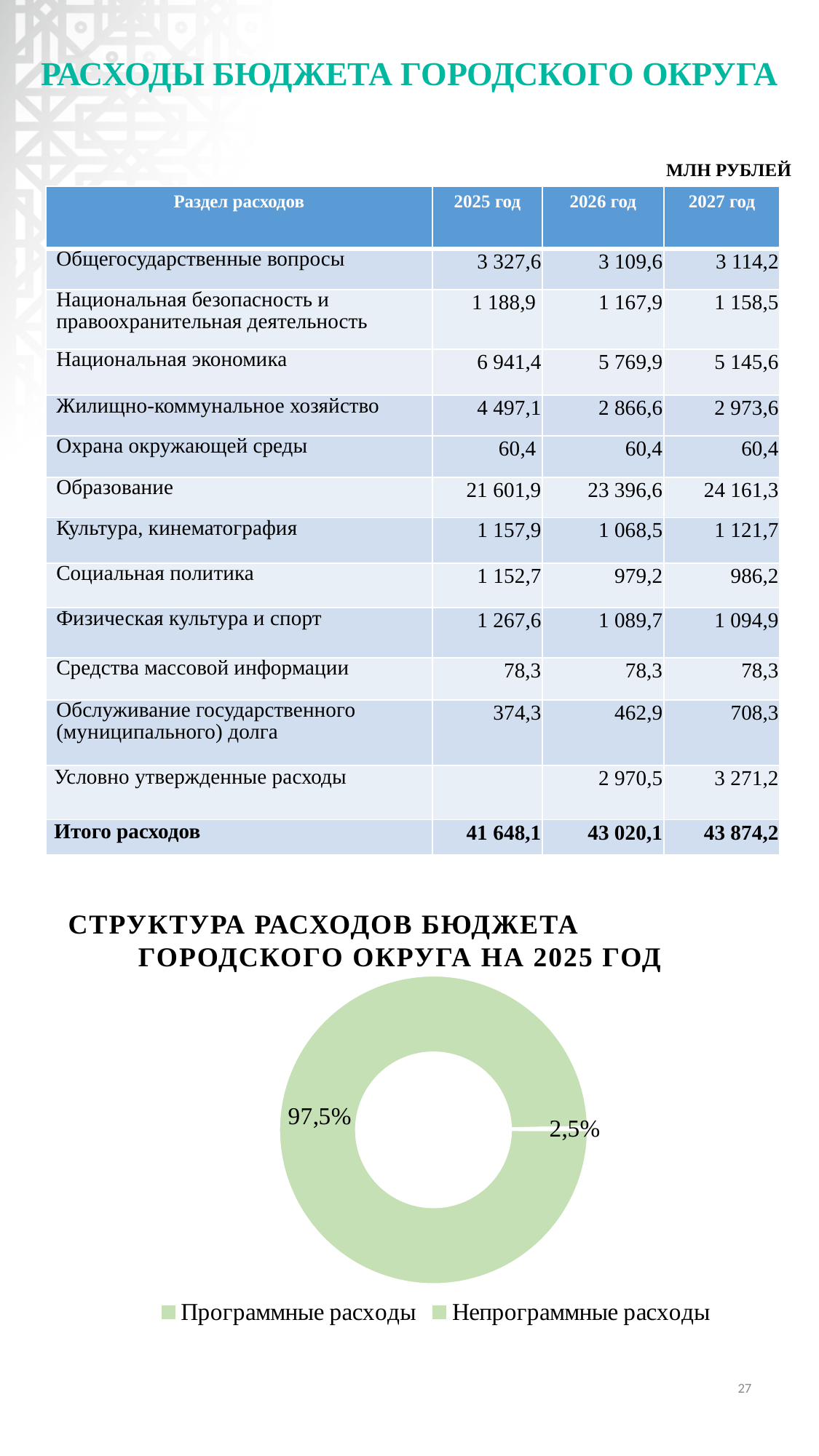
In the doughnut chart, is the larger slice greater or less than 90%? greater In the doughnut chart, what is the difference in percentage points between the two slices? 95 percentage points How many entries does the legend of the doughnut chart list? 2 What kind of chart is shown under the heading "СТРУКТУРА РАСХОДОВ БЮДЖЕТА ГОРОДСКОГО ОКРУГА НА 2025 ГОД"? Doughnut (pie) chart What is the share of the largest slice in the doughnut chart? 97,5% How many slices does the doughnut chart on the slide have? 2 What is the title of the doughnut chart on the slide? СТРУКТУРА РАСХОДОВ БЮДЖЕТА ГОРОДСКОГО ОКРУГА НА 2025 ГОД What is the share of the smallest slice in the doughnut chart? 2,5% What are the two legend entries of the doughnut chart? Программные расходы; Непрограммные расходы